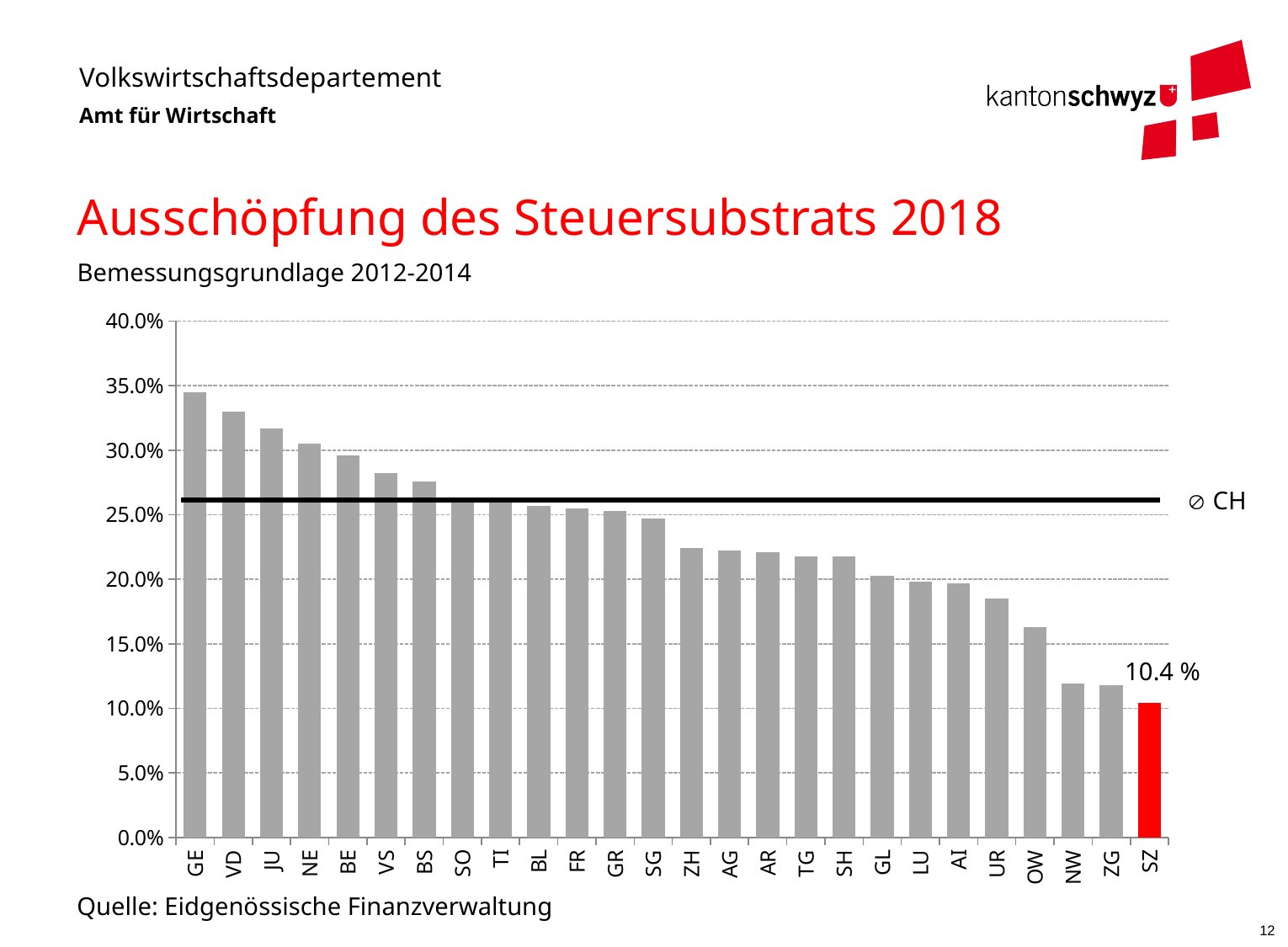
Do the values rise or fall from left to right along the x axis? fall How many cantons are shown on the x axis of the chart? 26 Which canton has the lowest value in the chart? SZ What is the value shown for SZ? 10.4 % What kind of chart is shown on the slide? bar chart Is the value for UR greater or less than 20.0%? less Which has the larger value, ZH or UR? ZH What colour is the bar for SZ? red Which canton has the highest value in the chart? GE Is the value for NW greater or less than 15.0%? less Is the value for VS greater or less than 25.0%? greater